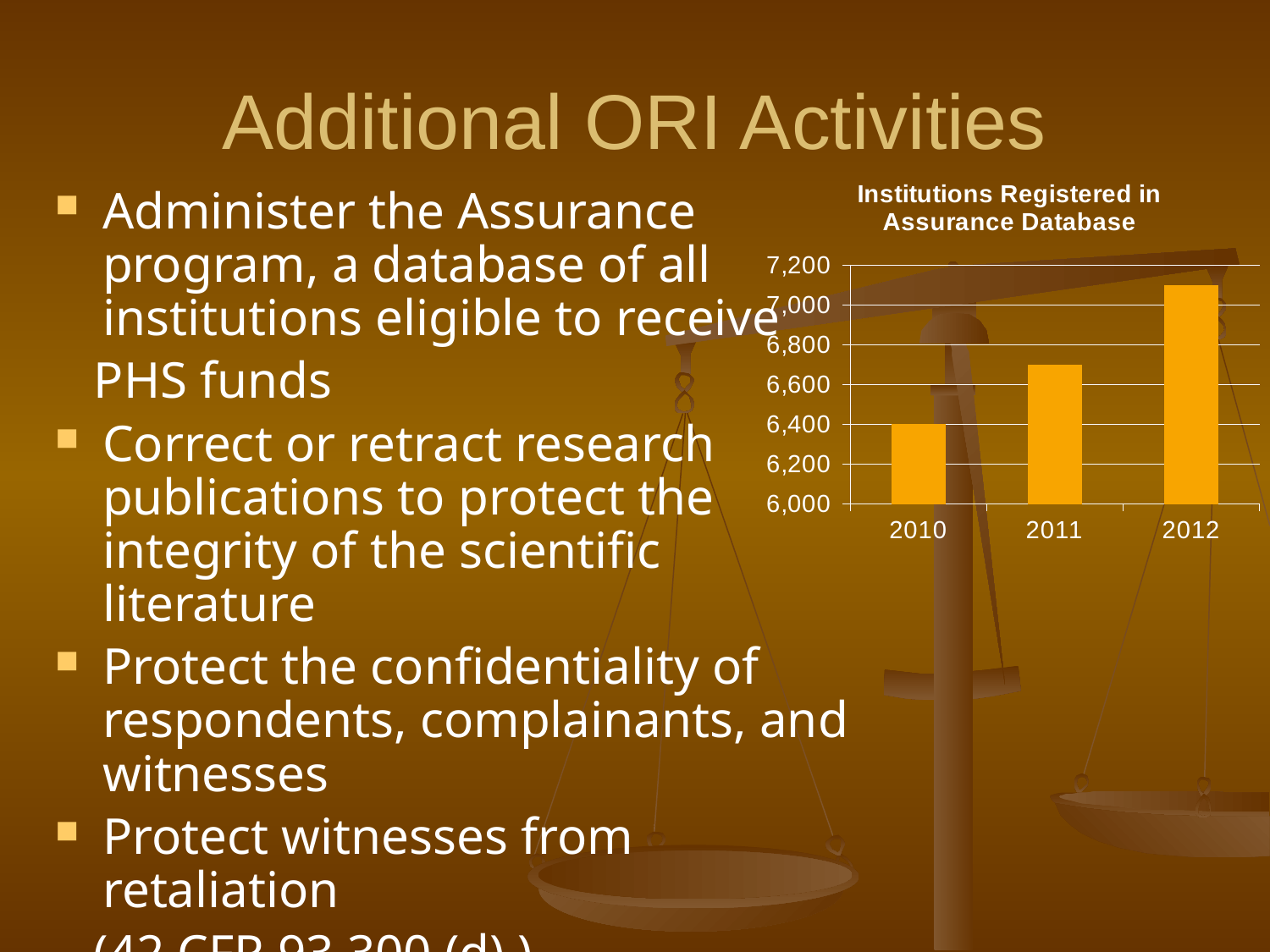
What is the title of the chart? Institutions Registered in Assurance Database Is the value for 2012 greater or less than 7,000? greater Is the value for 2011 greater or less than 6,800? less Which year has the larger value, 2011 or 2012? 2012 Which year has the lowest number of institutions registered in the Assurance Database? 2010 Do the values rise or fall from 2010 to 2012? rise What kind of chart is shown on the slide? bar chart What is the value for 2010 in the chart? 6,400 Is the value for 2011 greater or less than 6,600? greater Which year has the highest number of institutions registered in the Assurance Database? 2012 How many years are shown on the x axis of the chart? 3